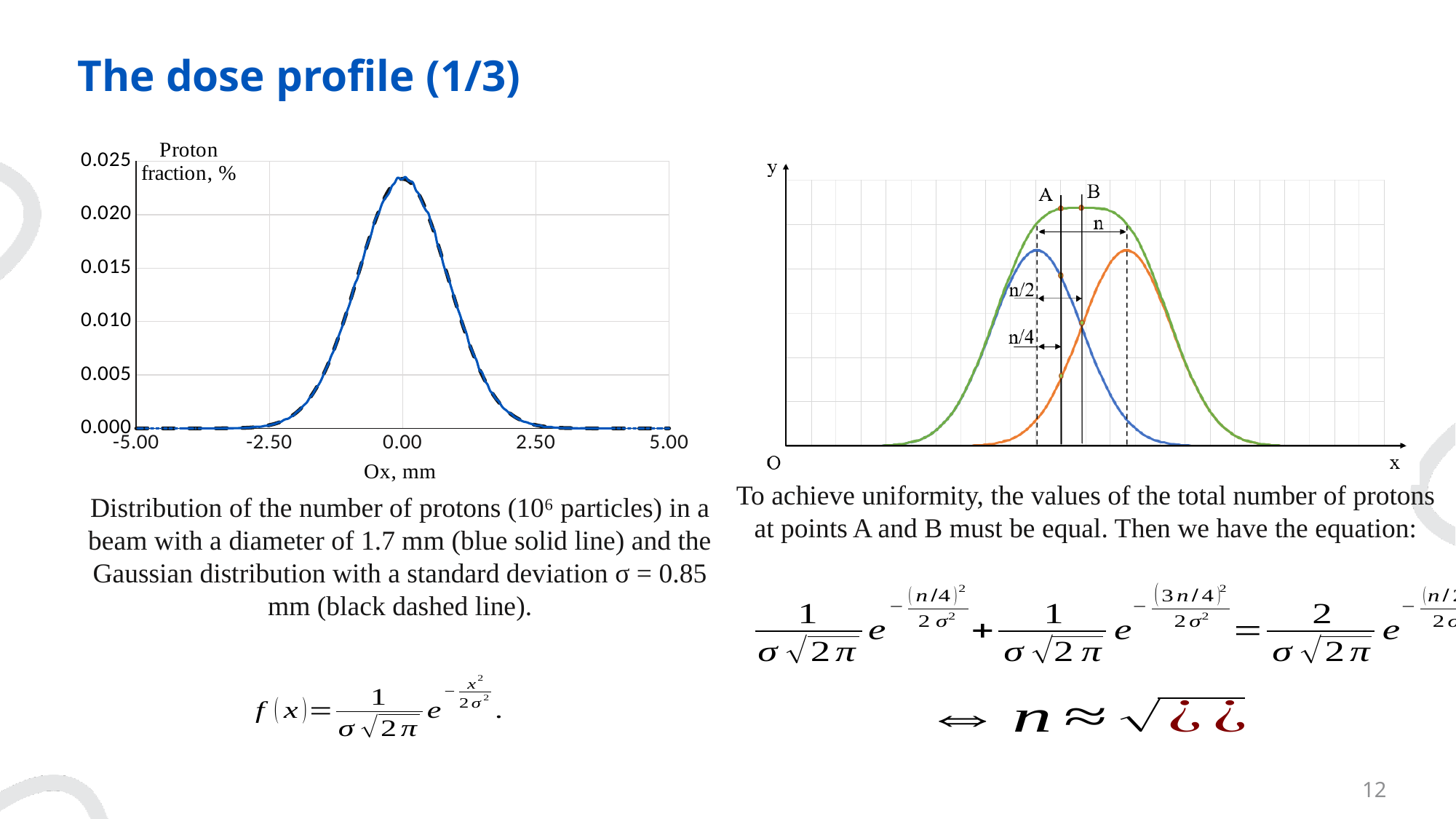
How many tick labels are shown on the x axis of the left chart? 5 On the left chart, is the peak value of the proton fraction greater or less than 0.025? less How many curves are plotted on the right chart? 3 On the left chart, is the proton fraction at Ox = 2.50 greater or less than 0.005? less On the left chart, is the peak value of the proton fraction greater or less than 0.020? greater On the right chart, which curve reaches the highest point: the blue, orange or green one? green On the left chart, does the proton fraction rise or fall as Ox goes from 0.00 to 5.00? fall On the left chart, at which Ox value does the proton fraction curve reach its peak? 0.00 What is the x-axis label of the left chart? Ox, mm What kind of chart is the left chart (Proton fraction vs Ox, mm)? line chart On the left chart, does the proton fraction rise or fall as Ox goes from -5.00 to 0.00? rise